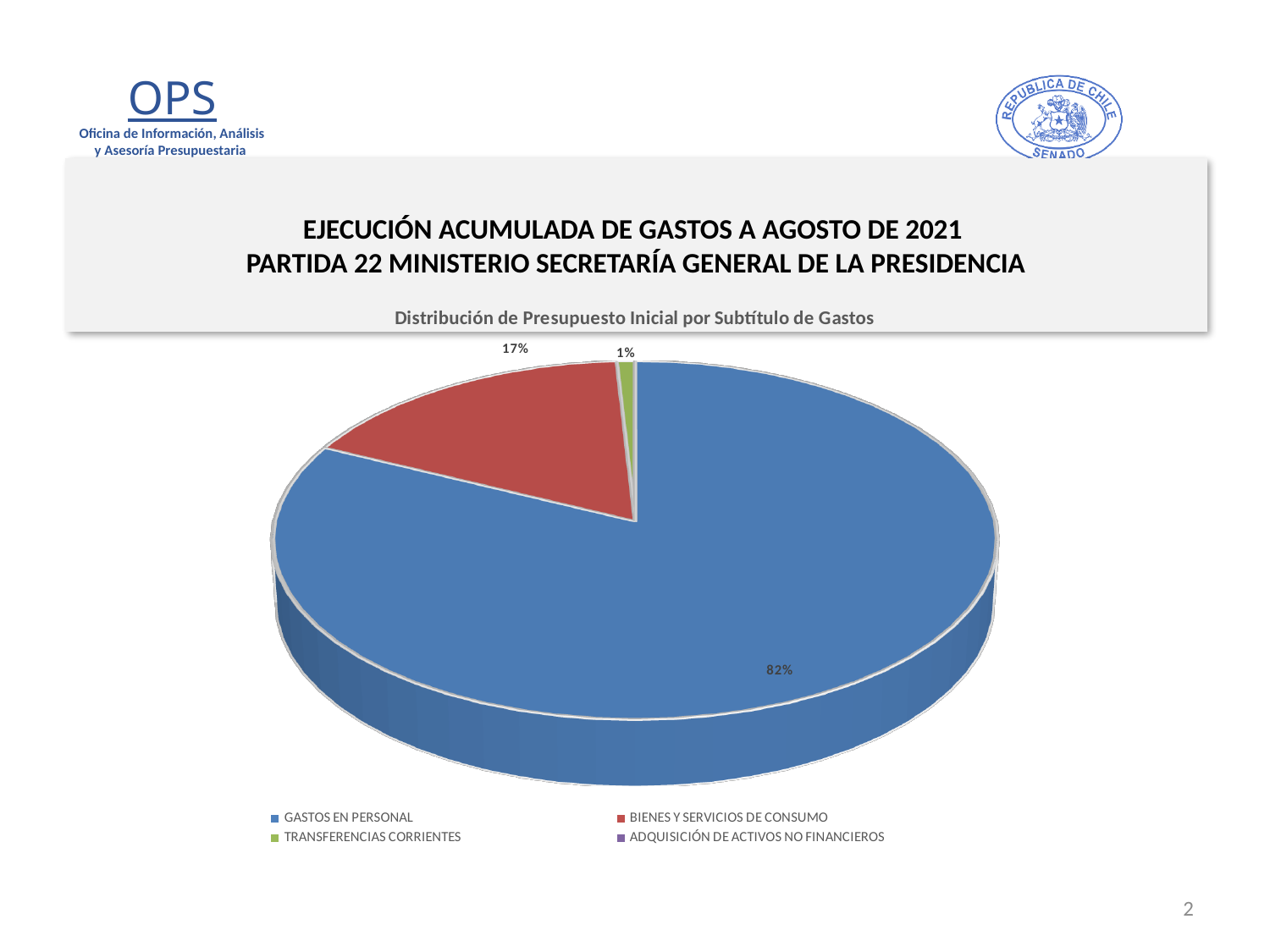
What is the difference in percentage points between GASTOS EN PERSONAL and BIENES Y SERVICIOS DE CONSUMO? 65 percentage points Which category has the largest slice of the pie? GASTOS EN PERSONAL What colour is the slice for BIENES Y SERVICIOS DE CONSUMO? Red Which is larger, the share for BIENES Y SERVICIOS DE CONSUMO or the share for TRANSFERENCIAS CORRIENTES? BIENES Y SERVICIOS DE CONSUMO How many entries does the chart legend list? 4 What kind of chart is shown on the slide? Pie chart Is the share for GASTOS EN PERSONAL greater or less than 50%? greater What is the title of the chart? Distribución de Presupuesto Inicial por Subtítulo de Gastos What share of the pie does GASTOS EN PERSONAL represent? 82% What percentage is shown for TRANSFERENCIAS CORRIENTES? 1% What percentage is shown for BIENES Y SERVICIOS DE CONSUMO? 17%